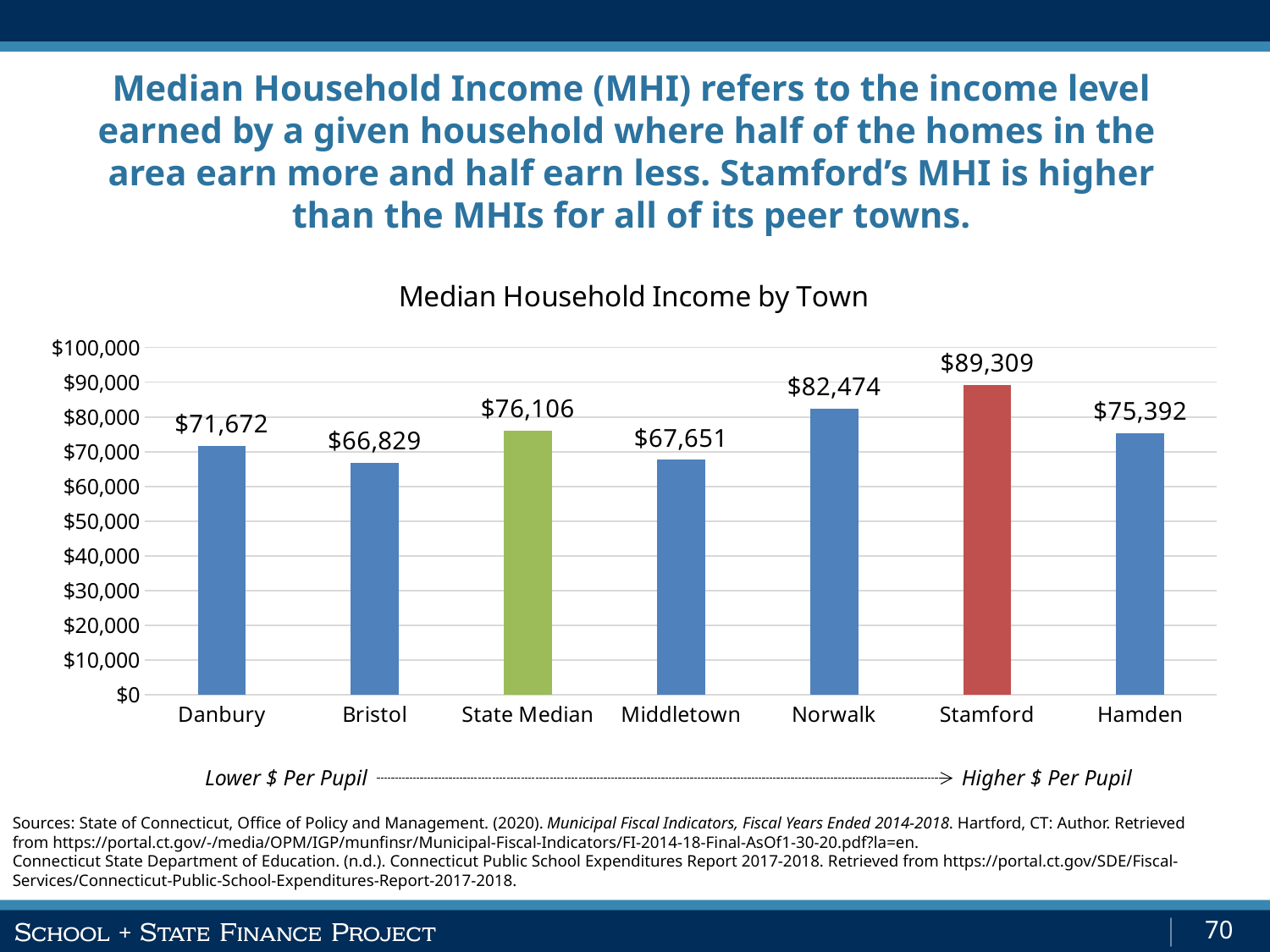
What is the value shown for State Median? $76,106 Which town has the highest median household income? Stamford What is the title of the chart? Median Household Income by Town Which category has the lowest median household income? Bristol What is the difference between Stamford's and Norwalk's median household income? $6,835 How many categories are shown on the x axis? 7 What kind of chart is shown? bar chart Is the value for Middletown greater or less than $70,000? less Which has a higher median household income, Danbury or Hamden? Hamden What is the median household income for Bristol? $66,829 What is the median household income for Stamford? $89,309 What colour is the bar for Stamford? red